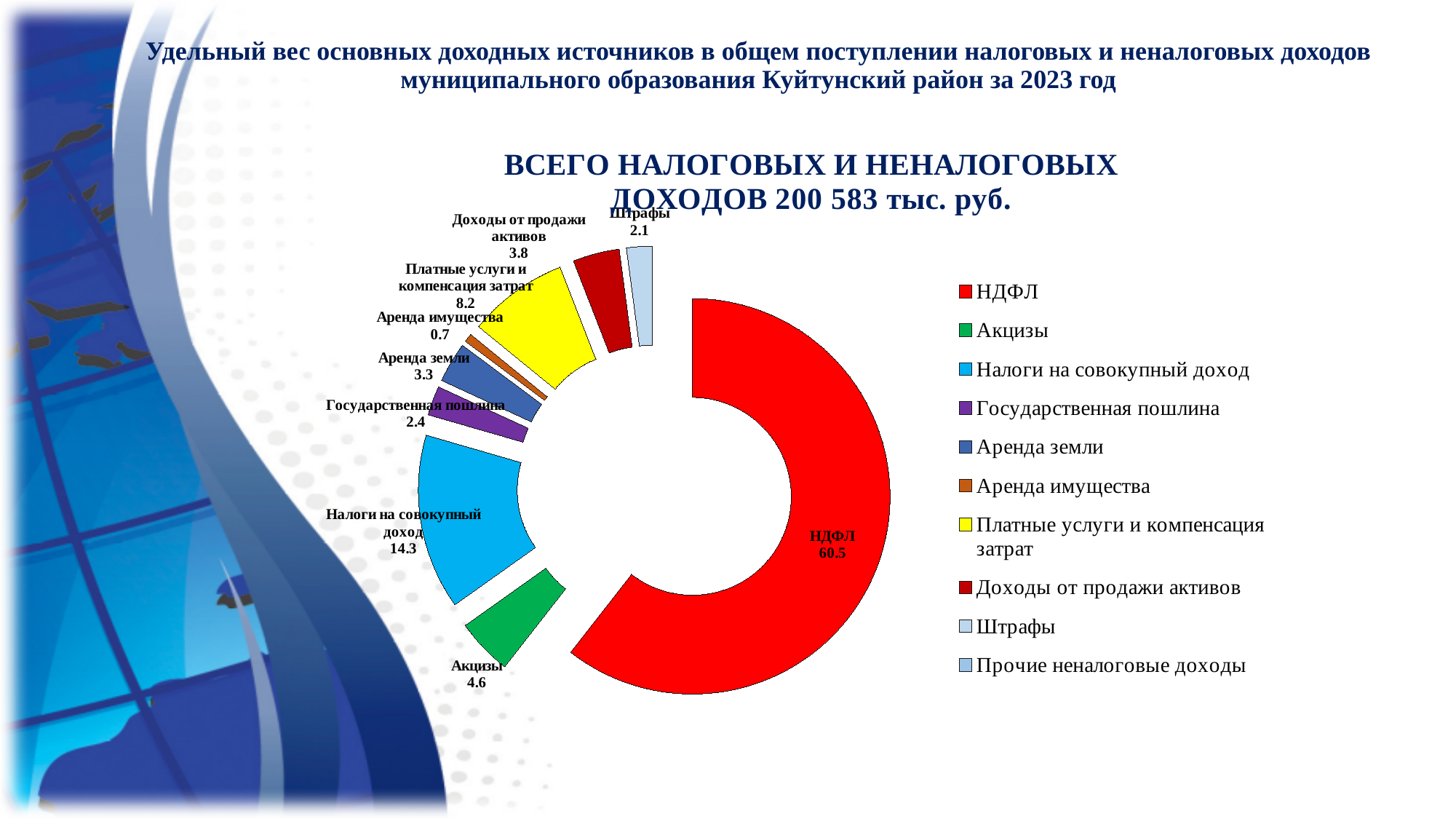
What is the value shown for Аренда имущества? 0.7 How many categories does the legend list? 10 What total amount is stated in the chart title? 200 583 тыс. руб. Which is larger: Платные услуги и компенсация затрат or Акцизы? Платные услуги и компенсация затрат What kind of chart is shown on the slide? Doughnut (pie) chart What is the value shown for Налоги на совокупный доход? 14.3 What is the difference between the values for НДФЛ and Налоги на совокупный доход? 46.2 Which category has the largest share on the chart? НДФЛ What is the value shown for Штрафы? 2.1 What is the difference between the values for Акцизы and Штрафы? 2.5 What is the value shown for НДФЛ on the chart? 60.5 What is the value shown for Платные услуги и компенсация затрат? 8.2